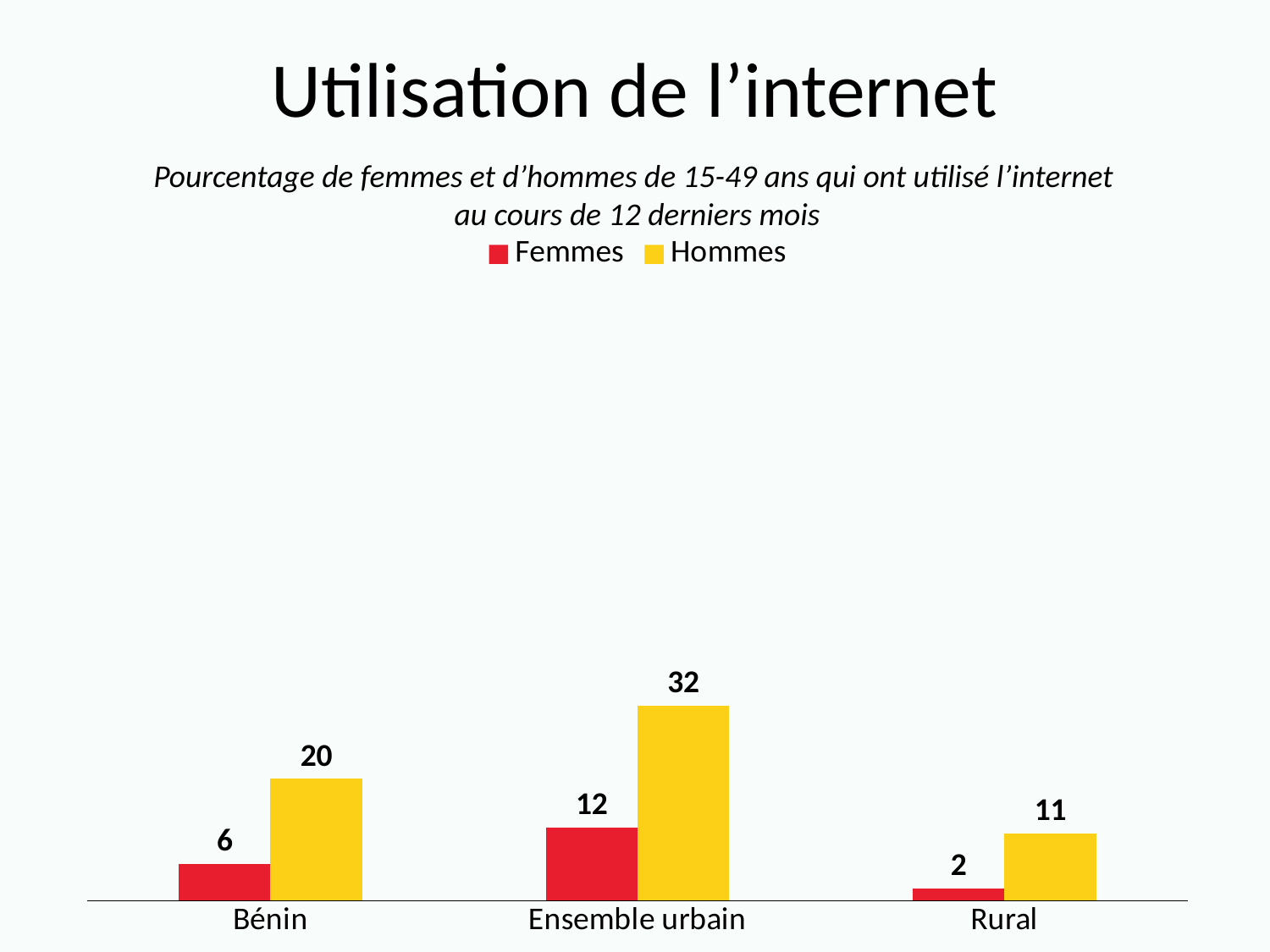
What is the difference between the Hommes values for Bénin and Rural? 9 What is the value for Hommes in Ensemble urbain? 32 What kind of chart is shown on the slide? Bar chart What is the value for Hommes in Rural? 11 How many series does the legend list? 2 What is the difference between Hommes and Femmes in Ensemble urbain? 20 What is the value for Femmes in Rural? 2 Which category has the lowest value for Femmes? Rural Which is larger: Femmes in Ensemble urbain or Hommes in Rural? Femmes in Ensemble urbain How many categories are shown on the x axis? 3 What is the value for Femmes in Bénin? 6 Which category has the highest value for Hommes? Ensemble urbain